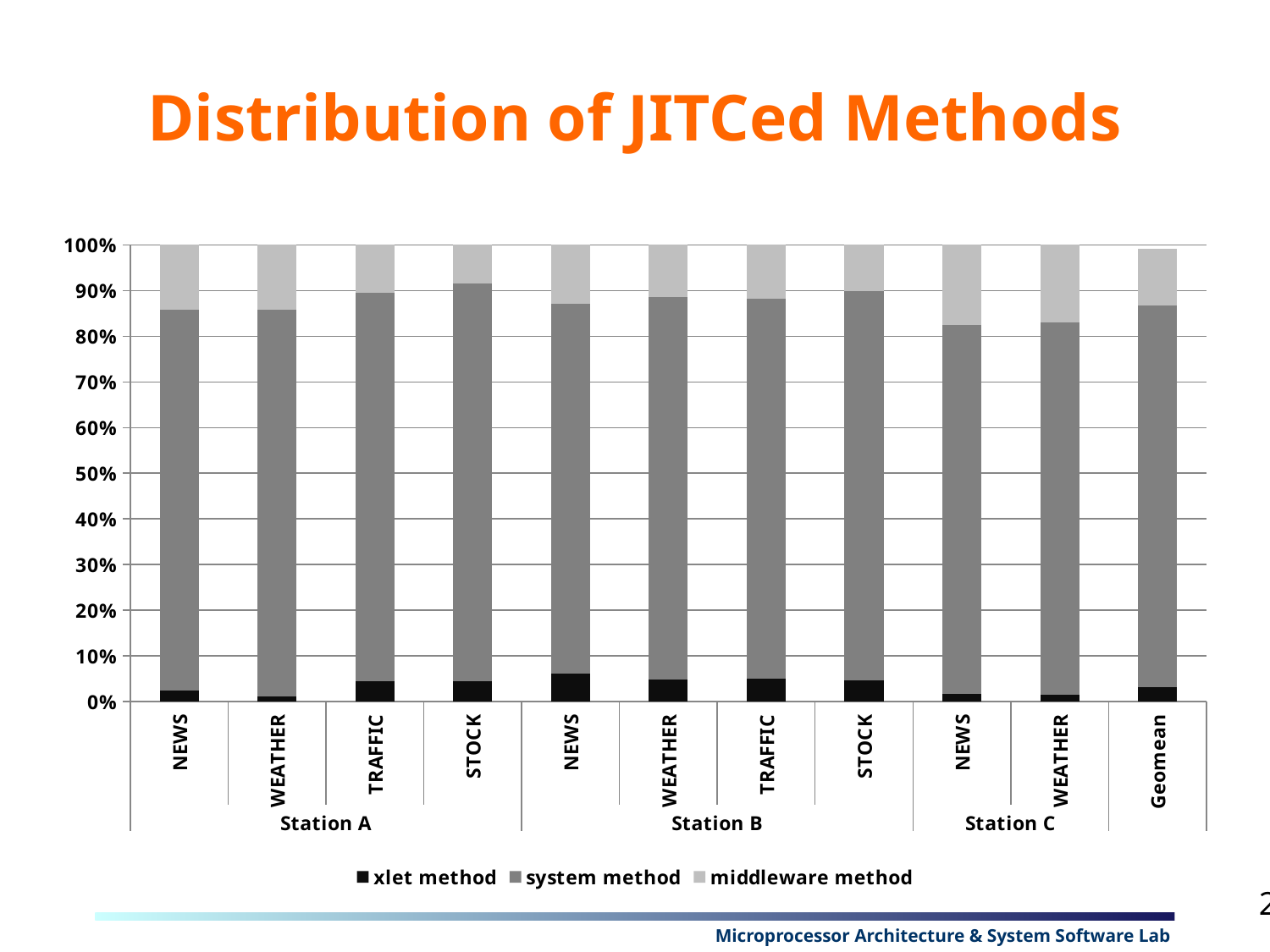
Which bar has the largest xlet method segment? Station B NEWS Is the xlet method segment larger for Station B NEWS or for Station A WEATHER? Station B NEWS Is the top of the system method segment for Station C NEWS greater or less than 90%? less What kind of chart is shown on the slide? bar chart Which series is shown in the lightest grey colour in the legend? middleware method What is the total of the stacked bar for Station A NEWS? 100% Is the middleware method segment larger for Station C NEWS or for Station A STOCK? Station C NEWS How many series does the legend list? 3 How many bars are plotted in the chart? 11 Is the xlet method value for Station B NEWS greater or less than 10%? less What is the title of the chart on the slide? Distribution of JITCed Methods Is the middleware method value for Station C WEATHER greater or less than 10%? greater